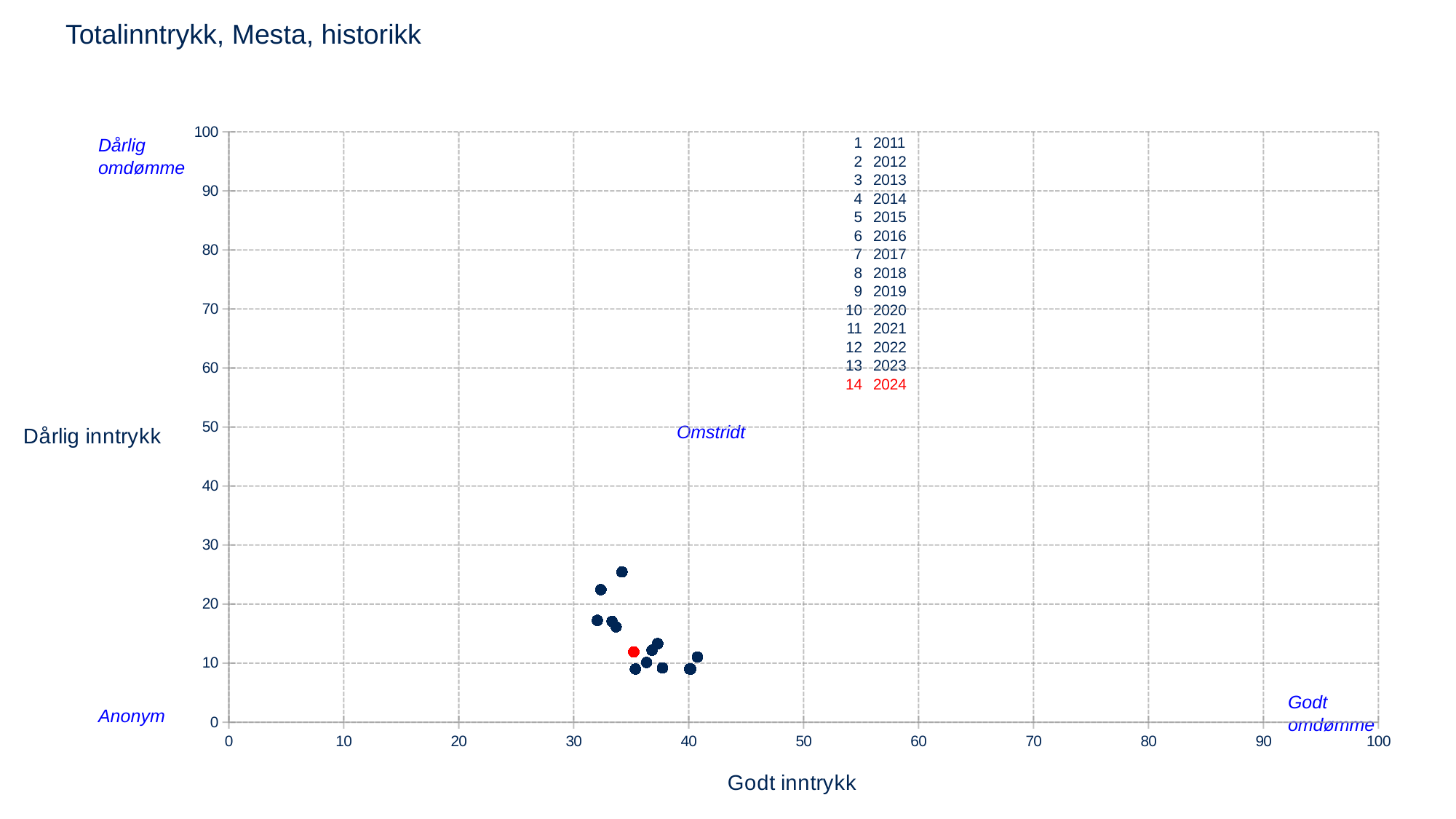
Is the horizontal (Godt inntrykk) value for the red 2024 point greater or less than 40? less What kind of chart is shown on the slide? scatter chart Is the vertical (Dårlig inntrykk) value for the red 2024 point greater or less than 20? less Which year is shown in red in the legend? 2024 What is the label of the x axis? Godt inntrykk How many entries does the legend list? 14 Is the highest horizontal value among all plotted points greater or less than 50? less What is the maximum value shown on the y axis? 100 How many data points are plotted on the chart? 14